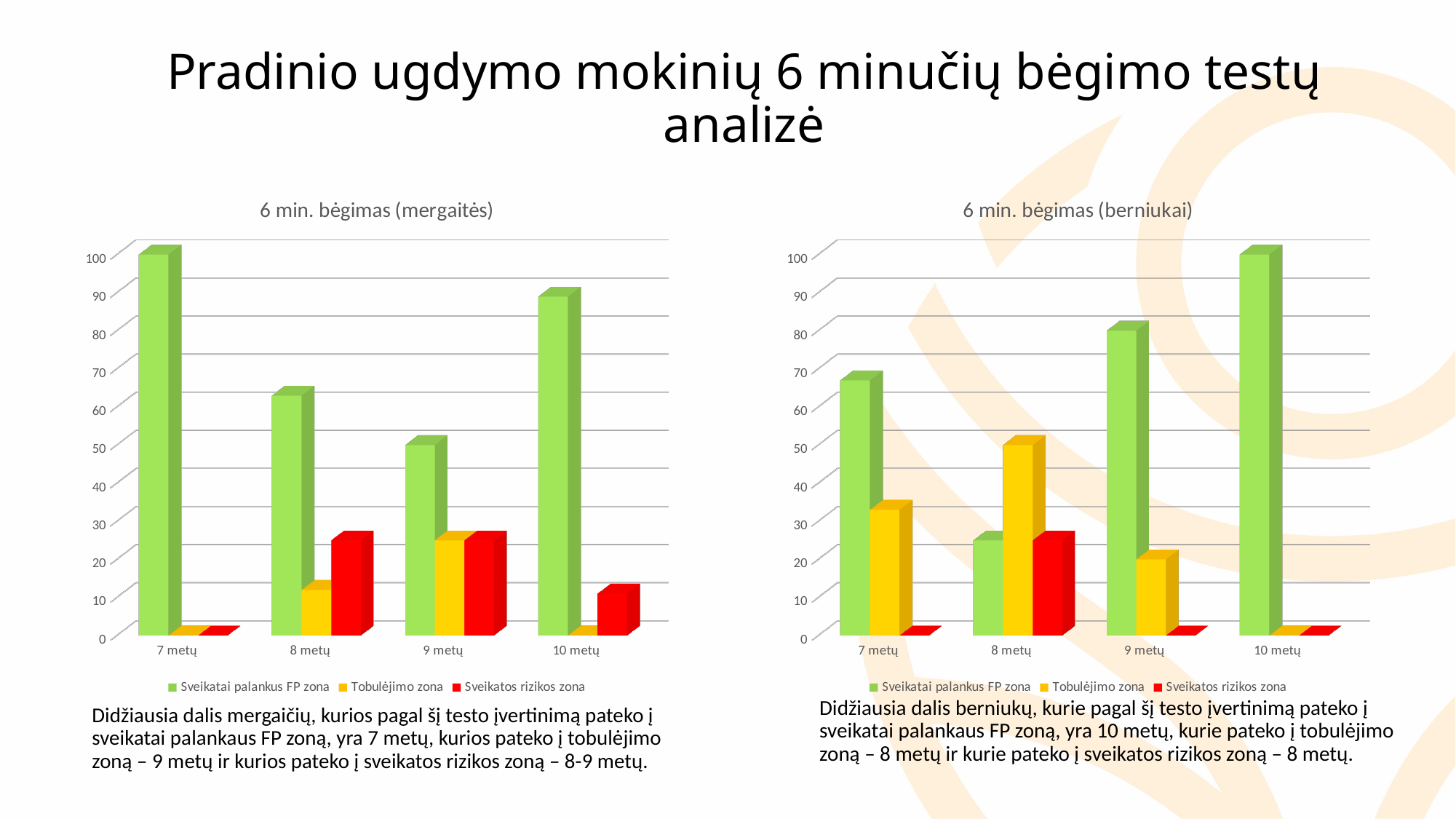
How many age categories are shown on the x axis of the "6 min. bėgimas (mergaitės)" chart? 4 In the "6 min. bėgimas (berniukai)" chart, which is larger at 8 metų: Sveikatai palankus FP zona or Tobulėjimo zona? Tobulėjimo zona What kind of chart is the "6 min. bėgimas (mergaitės)" chart? bar chart In the "6 min. bėgimas (mergaitės)" chart, is the value for Sveikatai palankus FP zona at 8 metų greater or less than 70? less In the "6 min. bėgimas (berniukai)" chart, which age group has the lowest value for Sveikatai palankus FP zona? 8 metų How many series does the legend of the "6 min. bėgimas (berniukai)" chart list? 3 In the "6 min. bėgimas (berniukai)" chart, which age group has the highest value for Sveikatai palankus FP zona? 10 metų What colour represents Sveikatos rizikos zona in the legend of the "6 min. bėgimas (mergaitės)" chart? red In the "6 min. bėgimas (berniukai)" chart, is the value for Tobulėjimo zona at 8 metų greater or less than 40? greater In the "6 min. bėgimas (mergaitės)" chart, which age group has the highest value for Sveikatai palankus FP zona? 7 metų In the "6 min. bėgimas (mergaitės)" chart, which age group has the lowest value for Sveikatai palankus FP zona? 9 metų In the "6 min. bėgimas (mergaitės)" chart, which is larger at 10 metų: Sveikatai palankus FP zona or Sveikatos rizikos zona? Sveikatai palankus FP zona